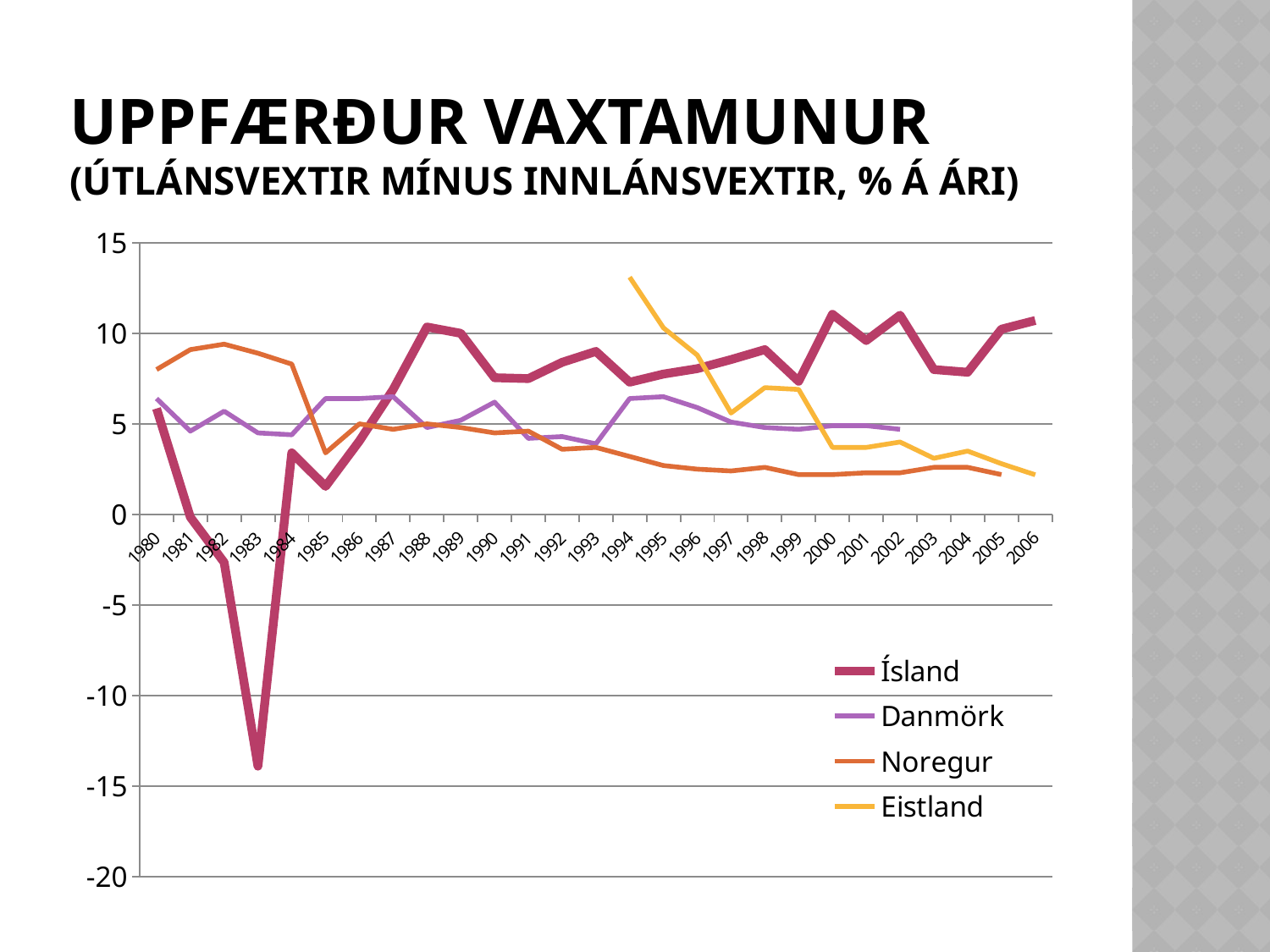
Is the value for Eistland in 1994 greater or less than 10? greater In which year does the Ísland series reach its lowest value? 1983 Is the value for Noregur in 2005 greater or less than 5? less In 2000, which series has the higher value, Ísland or Noregur? Ísland Is the value for Ísland in 1983 greater or less than -10? less Which series has the highest value in 1994? Eistland How many years are plotted along the x axis? 27 How many series does the legend list? 4 What kind of chart is shown on the slide? line chart Which series is drawn with the thickest line? Ísland Does the Eistland line generally rise or fall from 1994 to 2006? fall In 1983, which series has the higher value, Ísland or Danmörk? Danmörk